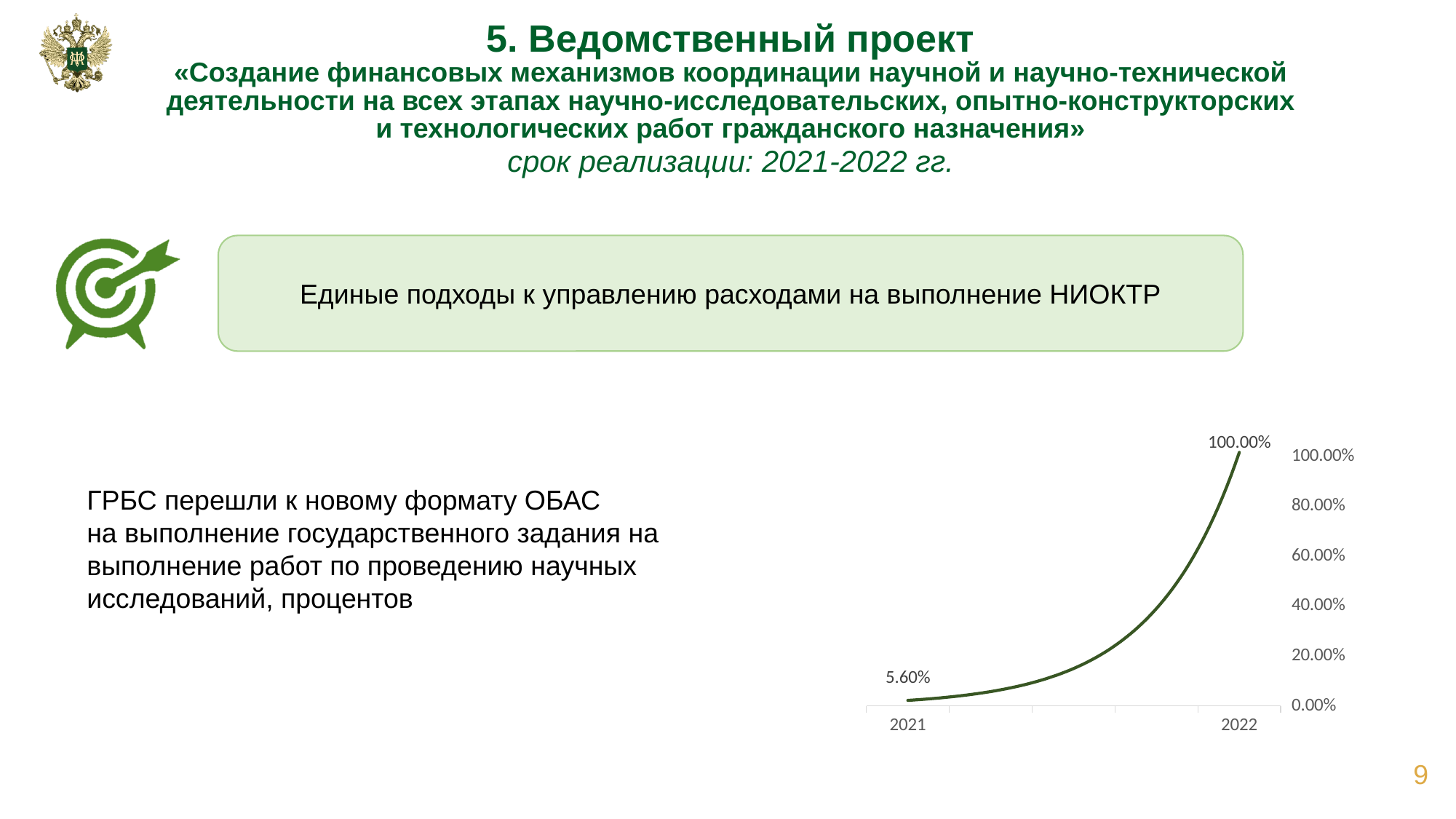
What is the highest tick value shown on the chart's vertical axis? 100.00% How many years are labelled on the x axis of the chart? 2 What is the value for 2021 on the chart? 5.60% What is the difference between the 2022 and 2021 values on the chart? 94.40% Do the values rise or fall from 2021 to 2022? rise Which year has the lowest value on the chart? 2021 What is the value for 2022 on the chart? 100.00% What kind of chart is shown on the slide? line chart Which year has the highest value on the chart? 2022 Is the value for 2022 greater or less than 80.00%? greater Which is larger, the value for 2021 or the value for 2022? 2022 Is the value for 2021 greater or less than 20.00%? less